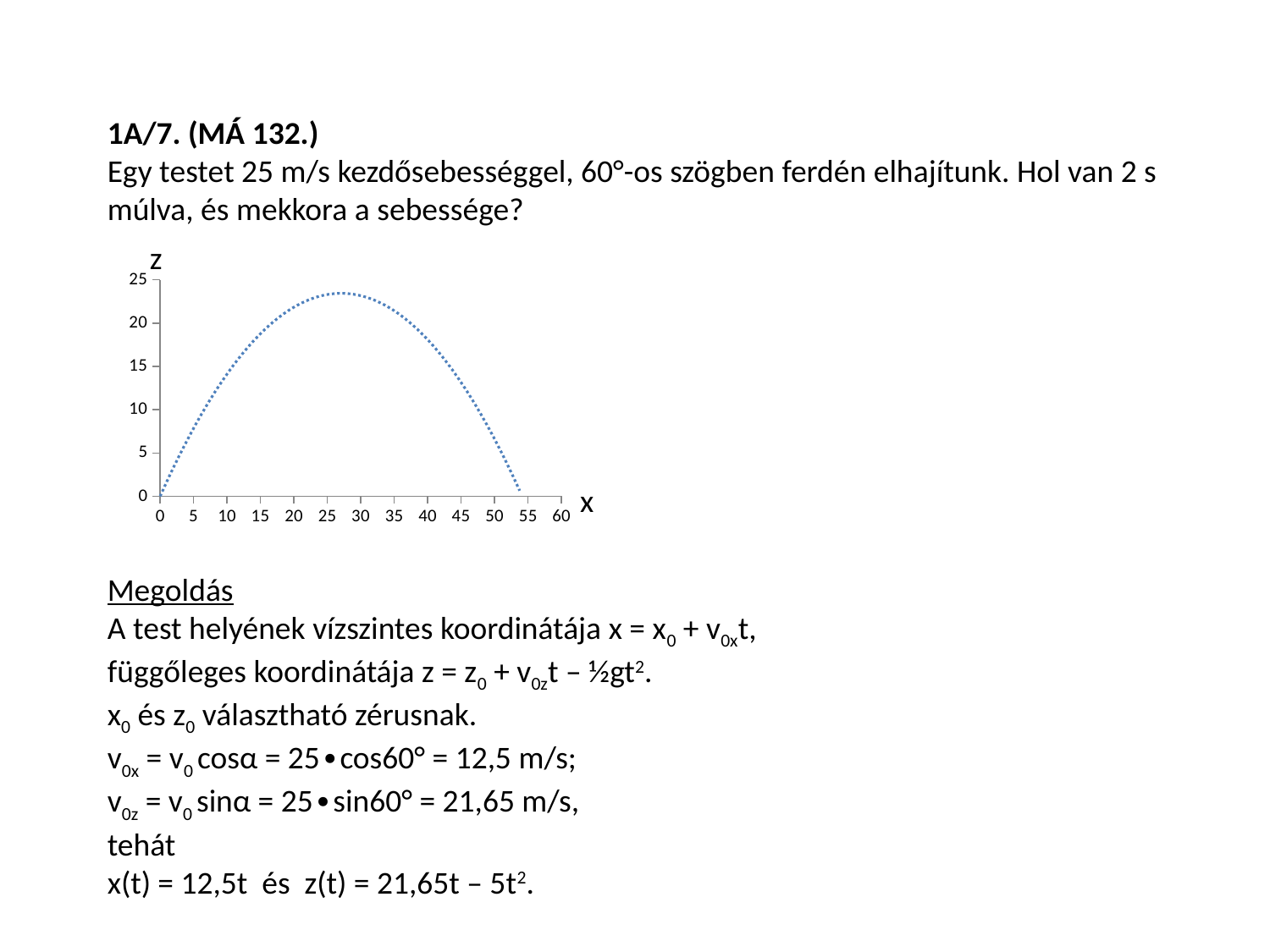
Is the z value of the curve at x = 10 greater or less than 10? greater What is the label of the horizontal axis of the chart? x Is the maximum z value reached by the curve greater or less than 20? greater Is the z value of the curve at x = 50 greater or less than 10? less What is the label of the vertical axis of the chart? z At what z value does the curve start at x = 0? 0 How does the z value change as x increases from 0 to 55? rises then falls What kind of chart is shown on the slide? line chart